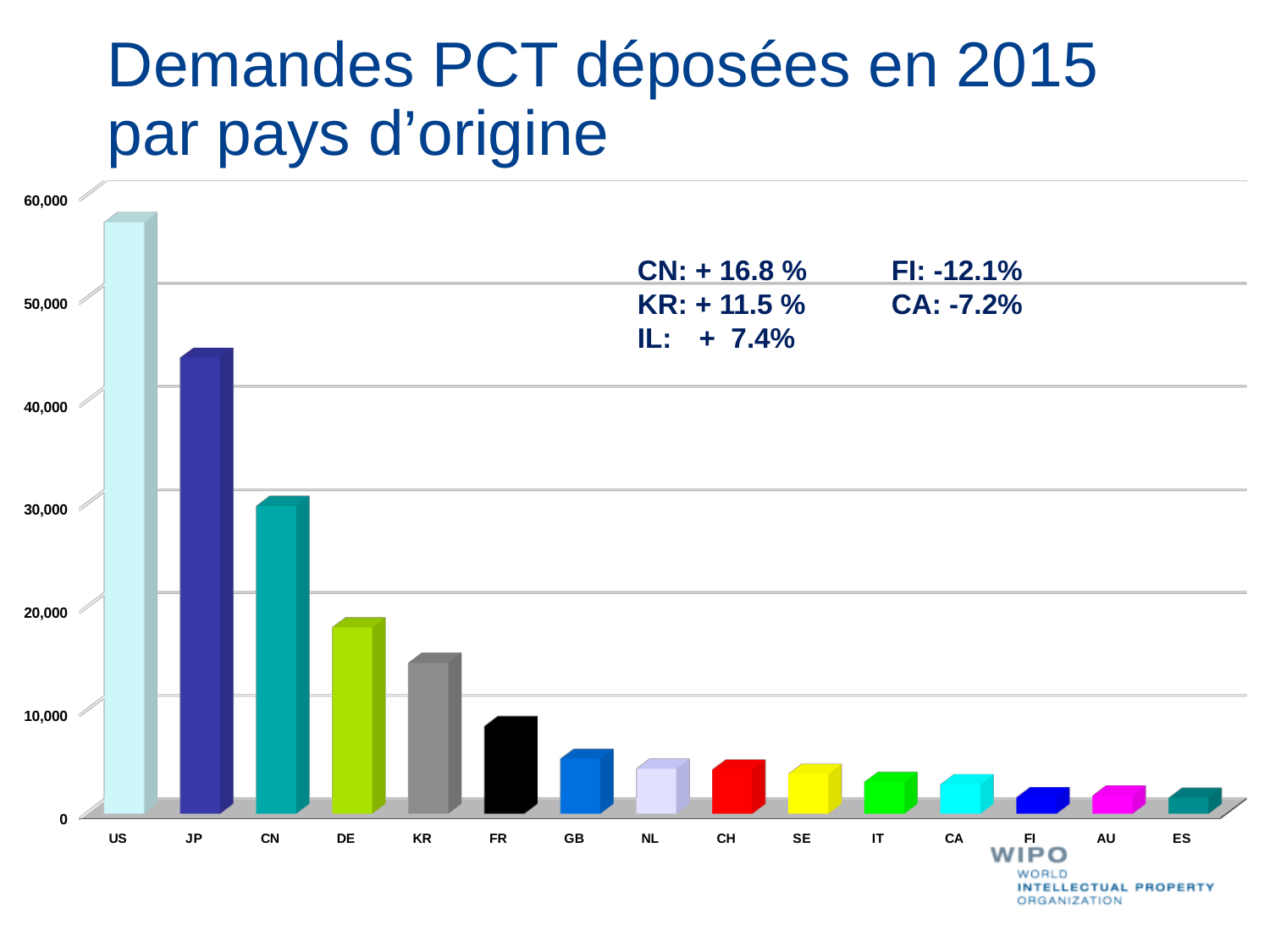
Is the value for FR greater or less than 10,000? less How many countries are shown on the x axis of the chart? 15 Which country has the highest number of PCT applications in the chart? US Do the values rise or fall moving from left to right along the x axis? fall Which country has the lowest number of PCT applications in the chart? ES Which has the larger value, DE or KR? DE Is the value for JP greater or less than 40,000? greater Which has the larger value, JP or CN? JP What kind of chart is shown on the slide? bar chart What percentage change is shown for KR in the text annotation on the chart? + 11.5 % Is the value for DE greater or less than 20,000? less